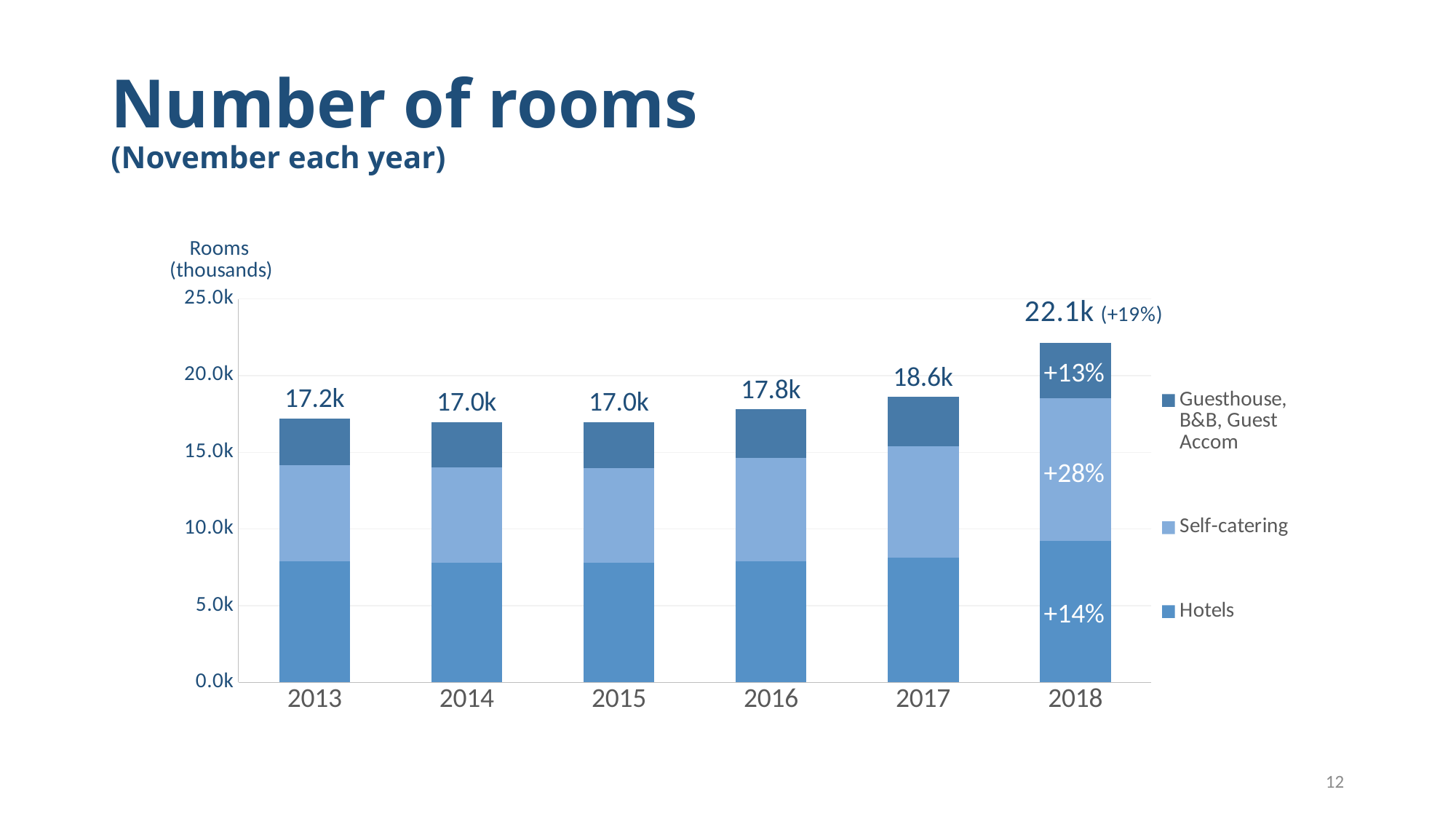
Which year has the larger total number of rooms, 2016 or 2013? 2016 Which year has the highest total number of rooms? 2018 What kind of chart is shown on the slide? Stacked bar chart What is the difference between the total rooms in 2018 and 2017? 3.5k Is the Hotels value for 2018 greater or less than 5.0k? greater What is the total number of rooms shown for 2013? 17.2k What is the label on the vertical axis? Rooms (thousands) What percentage increase is labelled on the Self-catering segment for 2018? +28% What is the total number of rooms shown for 2018? 22.1k How many years are shown on the x axis? 6 How many series does the legend list? 3 What is the total number of rooms shown for 2017? 18.6k